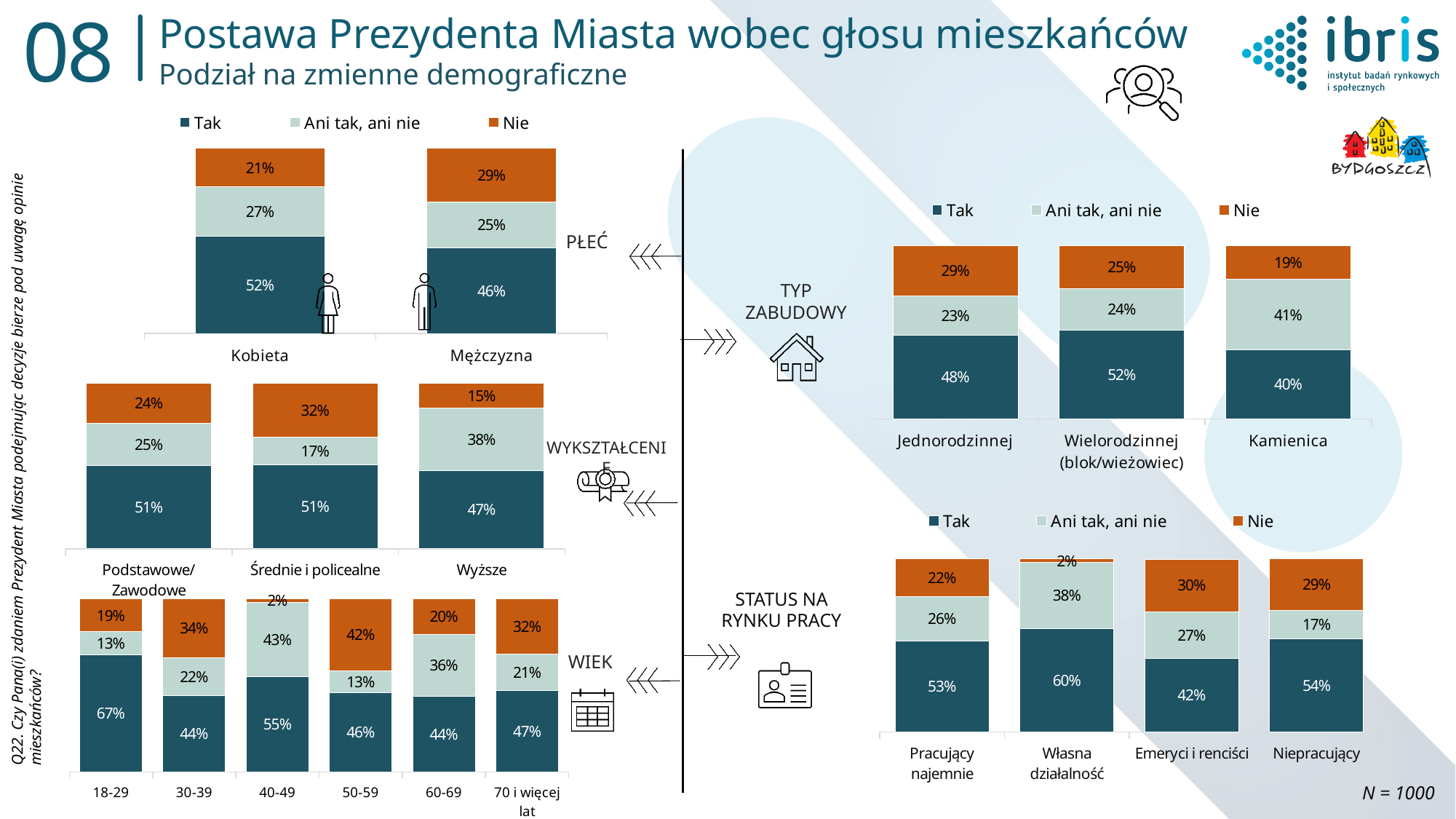
In the PŁEĆ chart, what percentage of Kobieta answered Tak? 52% In the WIEK chart, which age group has the highest Tak value? 18-29 In the PŁEĆ chart, how many percentage points higher is the Nie value for Mężczyzna than for Kobieta? 8 percentage points What type of chart is the STATUS NA RYNKU PRACY chart? Stacked bar chart In the WIEK chart, what is the Nie value for the 50-59 age group? 42% What are the three legend entries in the PŁEĆ chart? Tak, Ani tak, ani nie, Nie In the STATUS NA RYNKU PRACY chart, which has the larger Tak value: Własna działalność or Emeryci i renciści? Własna działalność How many age groups are shown in the WIEK chart? 6 In the TYP ZABUDOWY chart, which housing type has the lowest Tak value? Kamienica How many series does the legend of the TYP ZABUDOWY chart list? 3 In the STATUS NA RYNKU PRACY chart, what is the total of the Własna działalność bar? 100% In the WYKSZTAŁCENIE chart, what is the 'Ani tak, ani nie' value for Wyższe? 38%